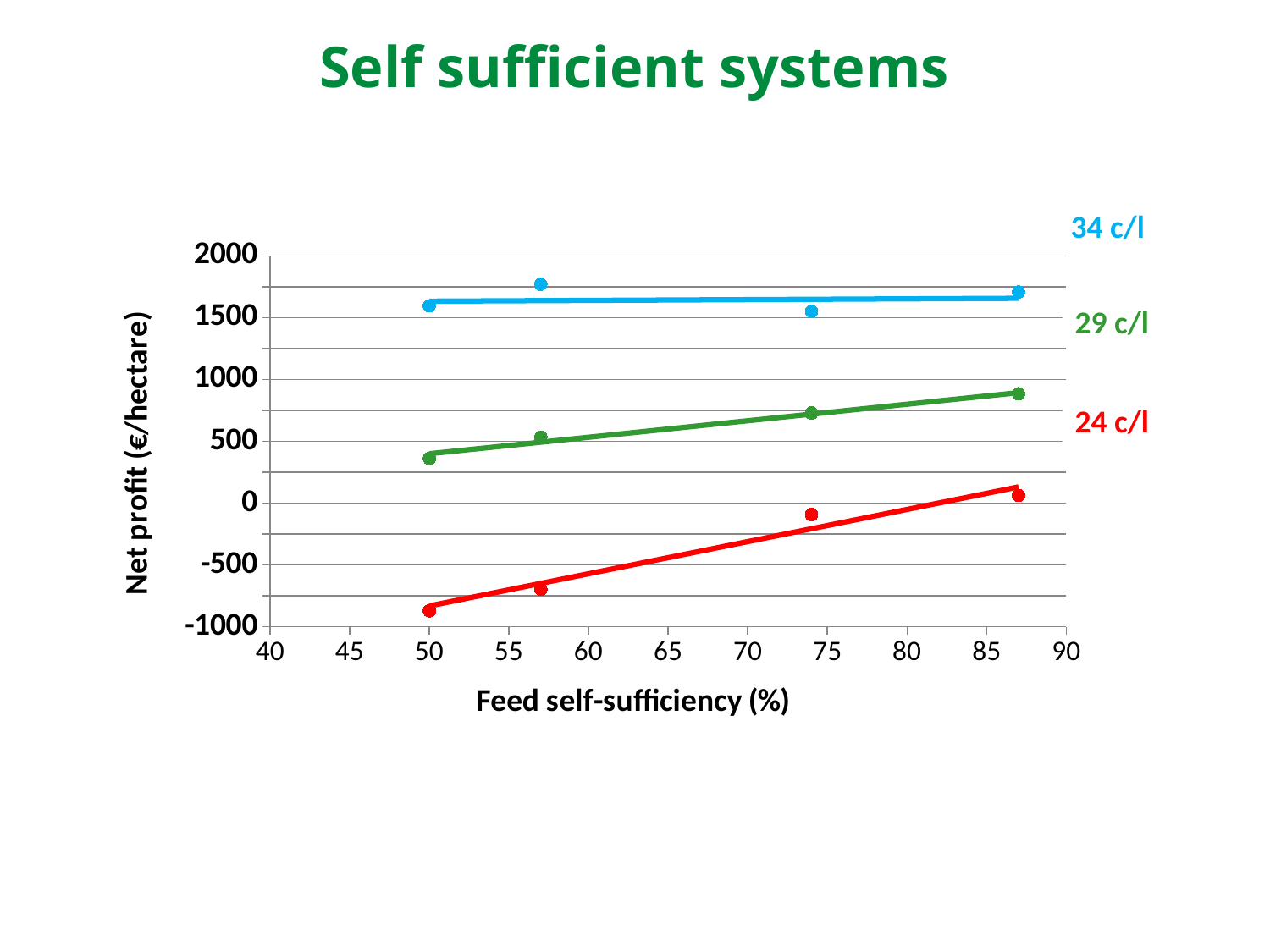
At 87% feed self-sufficiency, which series has the larger net profit, 29 c/l or 24 c/l? 29 c/l How many series (milk price levels) are plotted on the chart? 3 Does net profit for the 24 c/l series rise or fall as feed self-sufficiency increases? rise Does net profit for the 29 c/l series rise or fall as feed self-sufficiency increases? rise Is the net profit for the 29 c/l series at 50% feed self-sufficiency greater or less than 500? less Which series has the lowest net profit across the chart? 24 c/l Is the net profit for the 34 c/l series at 57% feed self-sufficiency greater or less than 1500? greater What kind of chart is shown on the slide? scatter chart What is the label of the x axis? Feed self-sufficiency (%) Which series has the highest net profit across the chart? 34 c/l Is the net profit for the 24 c/l series at 50% feed self-sufficiency greater or less than -500? less